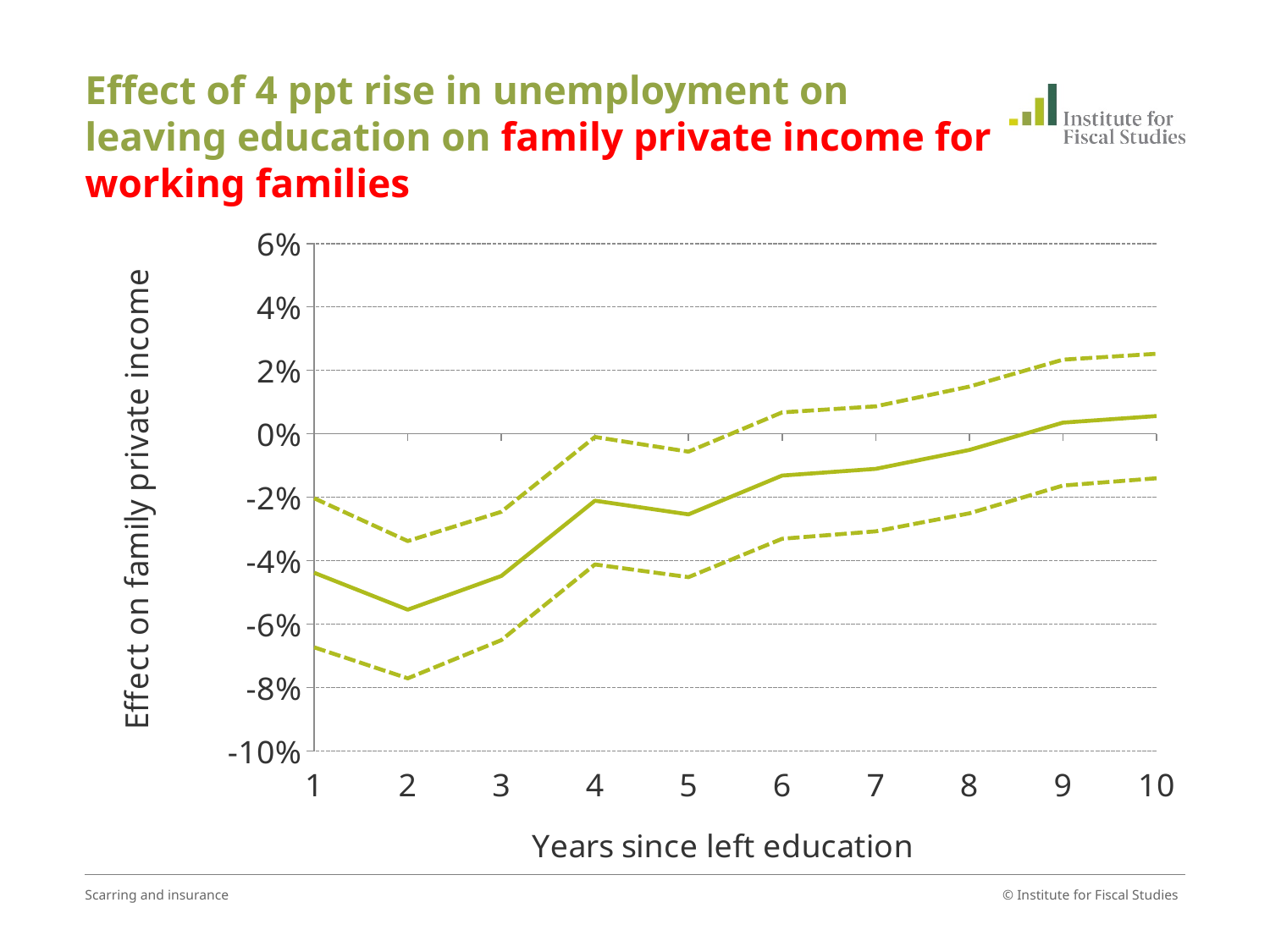
Is the value of the solid line at year 10 greater or less than 0%? greater Is the value of the upper dashed line at year 10 greater or less than 2%? greater What is the title of the x axis? Years since left education What type of chart is shown on the slide? Line chart Is the value of the solid line at year 2 greater or less than -4%? less How many lines are plotted on the chart? 3 What is the title of the y axis? Effect on family private income How many points along the x axis (years since left education) does the chart cover? 10 Overall, does the solid line rise or fall as years since leaving education increase from 1 to 10? Rise At which year since leaving education is the solid line at its lowest value? 2